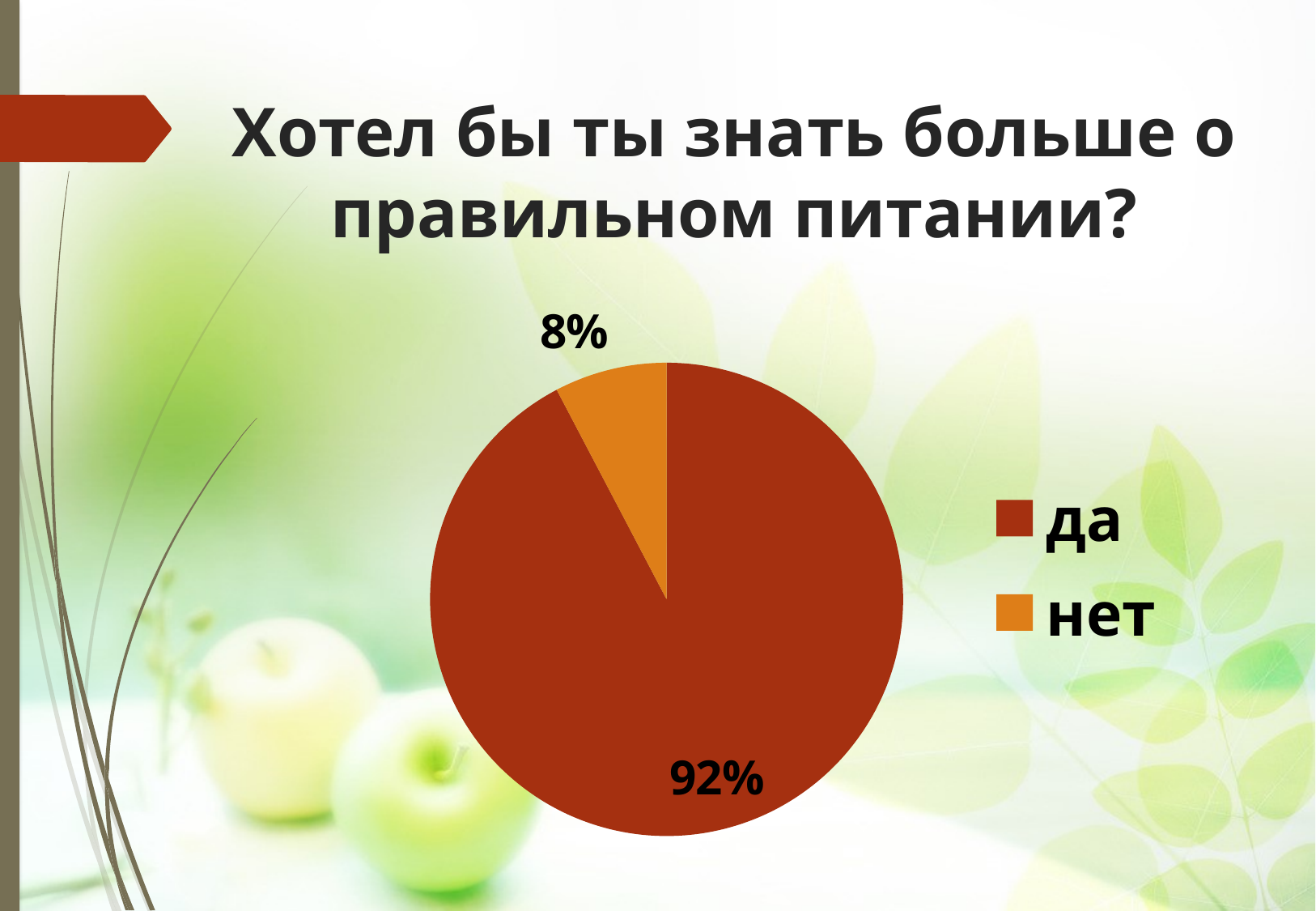
What percentage of respondents answered "да"? 92% What is the title of the chart on the slide? Хотел бы ты знать больше о правильном питании? How many entries does the legend list? 2 How many slices does the pie chart have? 2 What percentage of respondents answered "нет"? 8% What share of the pie does the "да" slice represent? 92% Which answer has the smallest share of the pie? нет What kind of chart is shown on the slide? pie chart What is the difference in percentage points between the "да" and "нет" slices? 84 Which slice is larger, "да" or "нет"? да Which answer has the largest share of the pie? да Which colour represents "нет" in the pie chart? orange